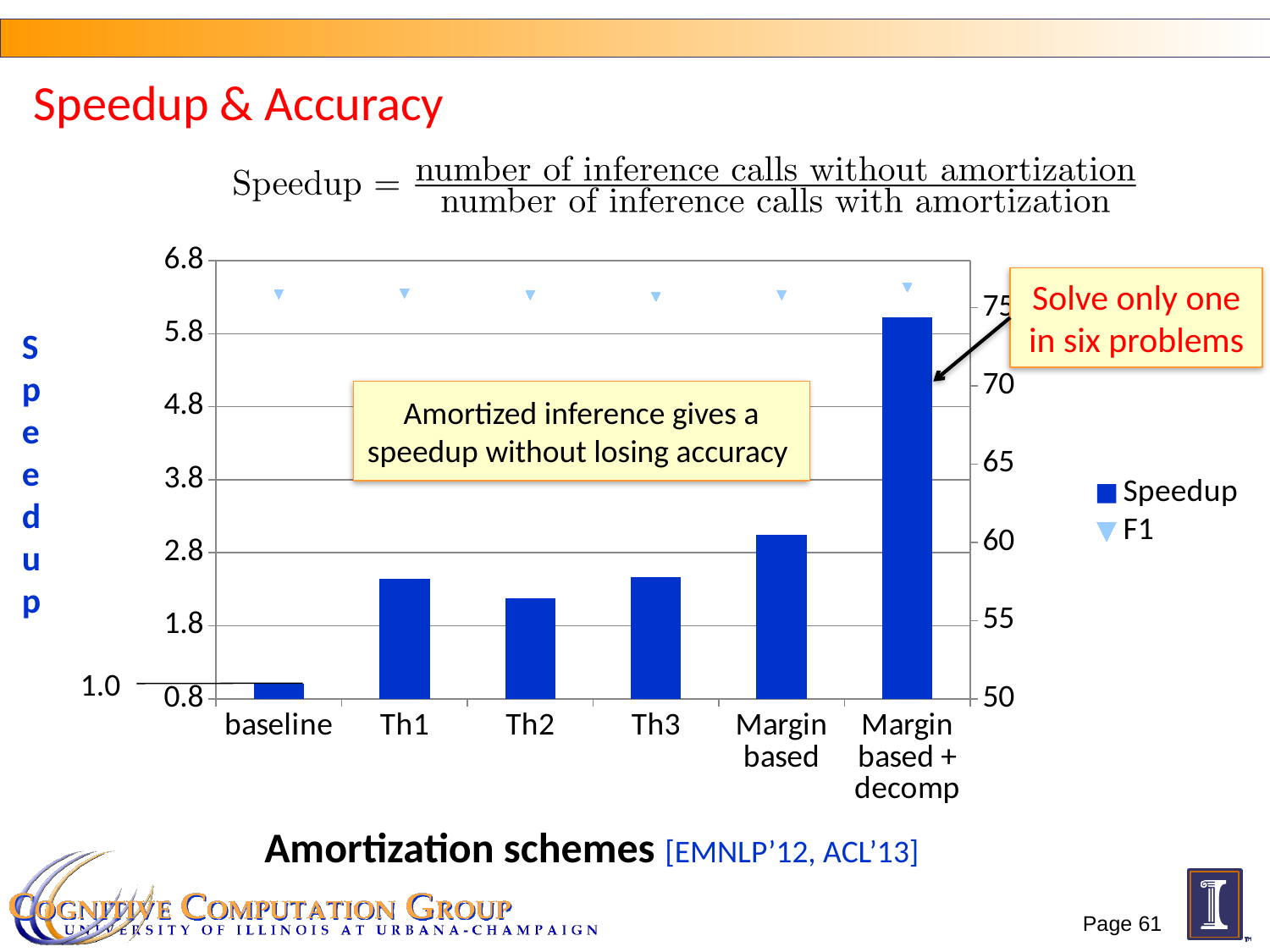
What kind of chart is shown on the slide? bar chart Is the speedup for Th2 greater or less than 1.8? greater Is the speedup for Margin based + decomp greater or less than 4.8? greater Which has the larger speedup, Th1 or Th2? Th1 Which amortization scheme has the lowest speedup? baseline Which has the larger speedup, Margin based or Th3? Margin based How many series does the legend list? 2 Is the speedup for Th1 greater or less than 2.8? less How many amortization schemes (categories) are shown on the x axis? 6 What are the two series named in the legend? Speedup and F1 Which amortization scheme has the highest speedup? Margin based + decomp What is the speedup value for the baseline? 1.0